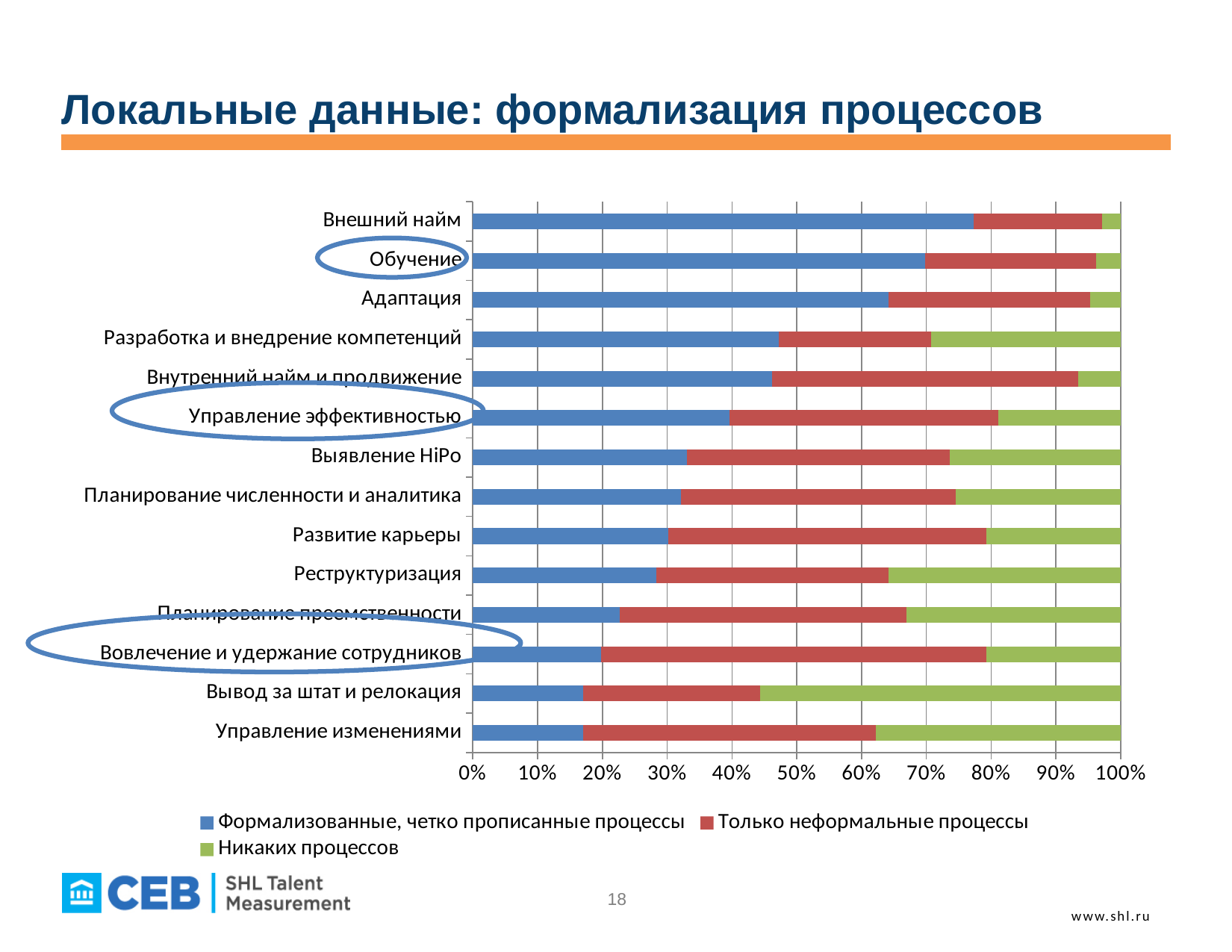
Which has a larger share of 'Формализованные, четко прописанные процессы': Выявление HiPo or Планирование преемственности? Выявление HiPo Is the share of 'Формализованные, четко прописанные процессы' for Вовлечение и удержание сотрудников greater or less than 30%? less Going down the list of categories from top to bottom, does the share of 'Формализованные, четко прописанные процессы' increase or decrease? decrease Is the share of 'Никаких процессов' for Вывод за штат и релокация greater or less than 50%? greater Which category has the largest share of 'Формализованные, четко прописанные процессы'? Внешний найм What kind of chart is shown on the slide? Stacked bar chart Which has a larger share of 'Формализованные, четко прописанные процессы': Обучение or Адаптация? Обучение Which category has the largest share of 'Никаких процессов'? Вывод за штат и релокация How many HR process categories are listed on the vertical axis of the chart? 14 Is the share of 'Формализованные, четко прописанные процессы' for Управление эффективностью greater or less than 50%? less How many series does the chart legend list? 3